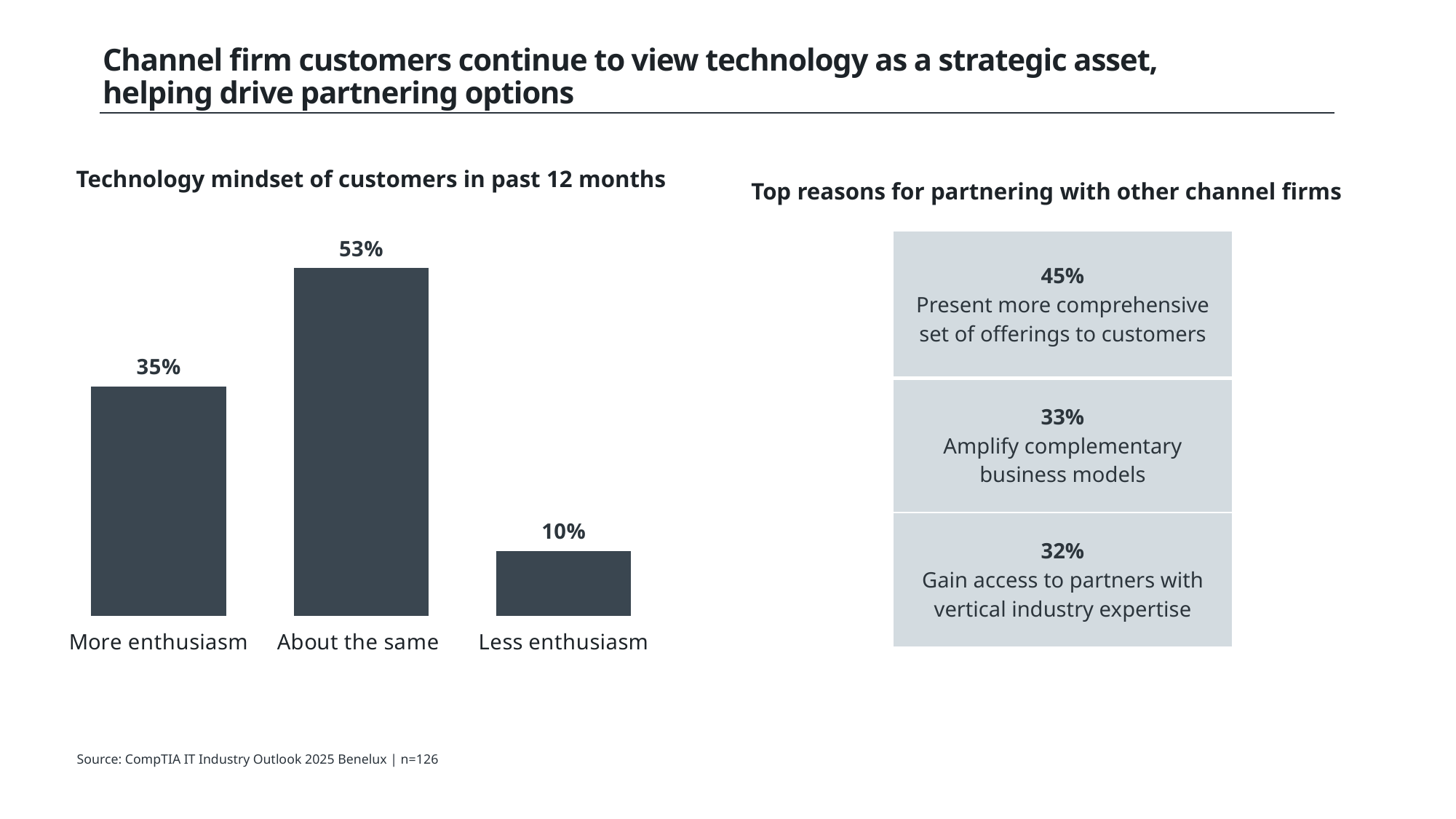
In the 'Technology mindset of customers in past 12 months' chart, which category has the lowest value? Less enthusiasm In the 'Top reasons for partnering with other channel firms' panel, what percentage is given for 'Amplify complementary business models'? 33% In the 'Technology mindset of customers in past 12 months' chart, what is the value for 'Less enthusiasm'? 10% How many categories are shown in the 'Technology mindset of customers in past 12 months' chart? 3 In the 'Technology mindset of customers in past 12 months' chart, what is the value for 'About the same'? 53% In the 'Technology mindset of customers in past 12 months' chart, which category has the highest value? About the same What kind of chart is 'Technology mindset of customers in past 12 months'? Bar chart In the 'Technology mindset of customers in past 12 months' chart, what is the value for 'More enthusiasm'? 35% In the 'Top reasons for partnering with other channel firms' panel, which reason has the highest percentage? Present more comprehensive set of offerings to customers In the 'Technology mindset of customers in past 12 months' chart, what is the difference between 'About the same' and 'More enthusiasm'? 18% In the 'Technology mindset of customers in past 12 months' chart, what is the difference between 'More enthusiasm' and 'Less enthusiasm'? 25% In the 'Technology mindset of customers in past 12 months' chart, which is larger: 'More enthusiasm' or 'Less enthusiasm'? More enthusiasm